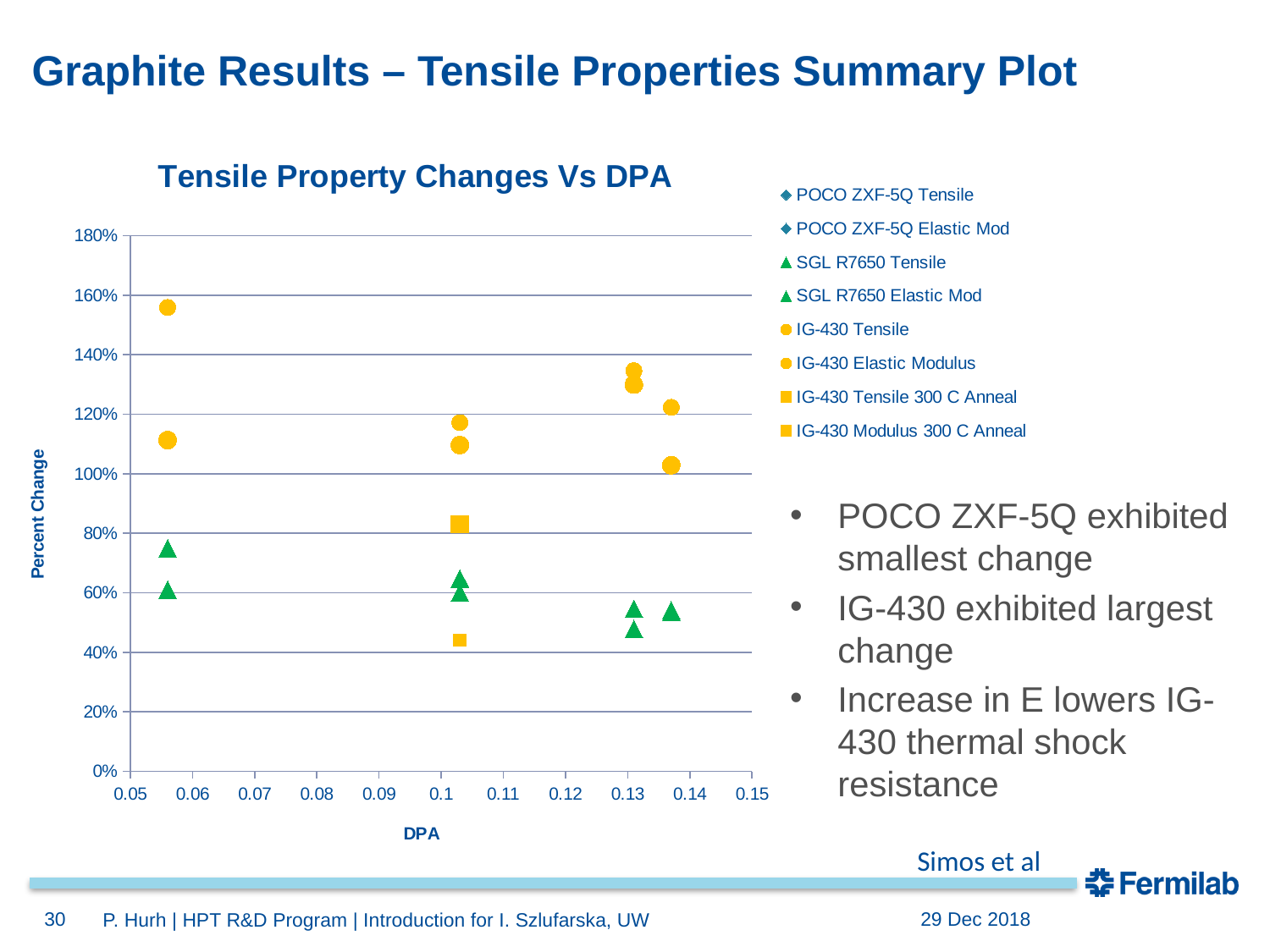
Which is larger at about 0.13 DPA: the IG-430 circle points or the SGL R7650 triangle points? IG-430 circle points What is the label of the vertical axis? Percent Change Is the lower yellow square (IG-430 300 C Anneal) point near 0.1 DPA greater or less than 60%? less Which material's points reach the highest Percent Change values on the chart? IG-430 What is the maximum value shown on the Percent Change axis? 180% What is the title of the chart? Tensile Property Changes Vs DPA Is the highest plotted point on the chart greater or less than 140%? greater What is the range of the DPA axis? 0.05 to 0.15 What kind of chart is shown on the slide? scatter chart Are the green triangle (SGL R7650) points greater or less than 80% on the Percent Change axis? less How many series does the legend list? 8